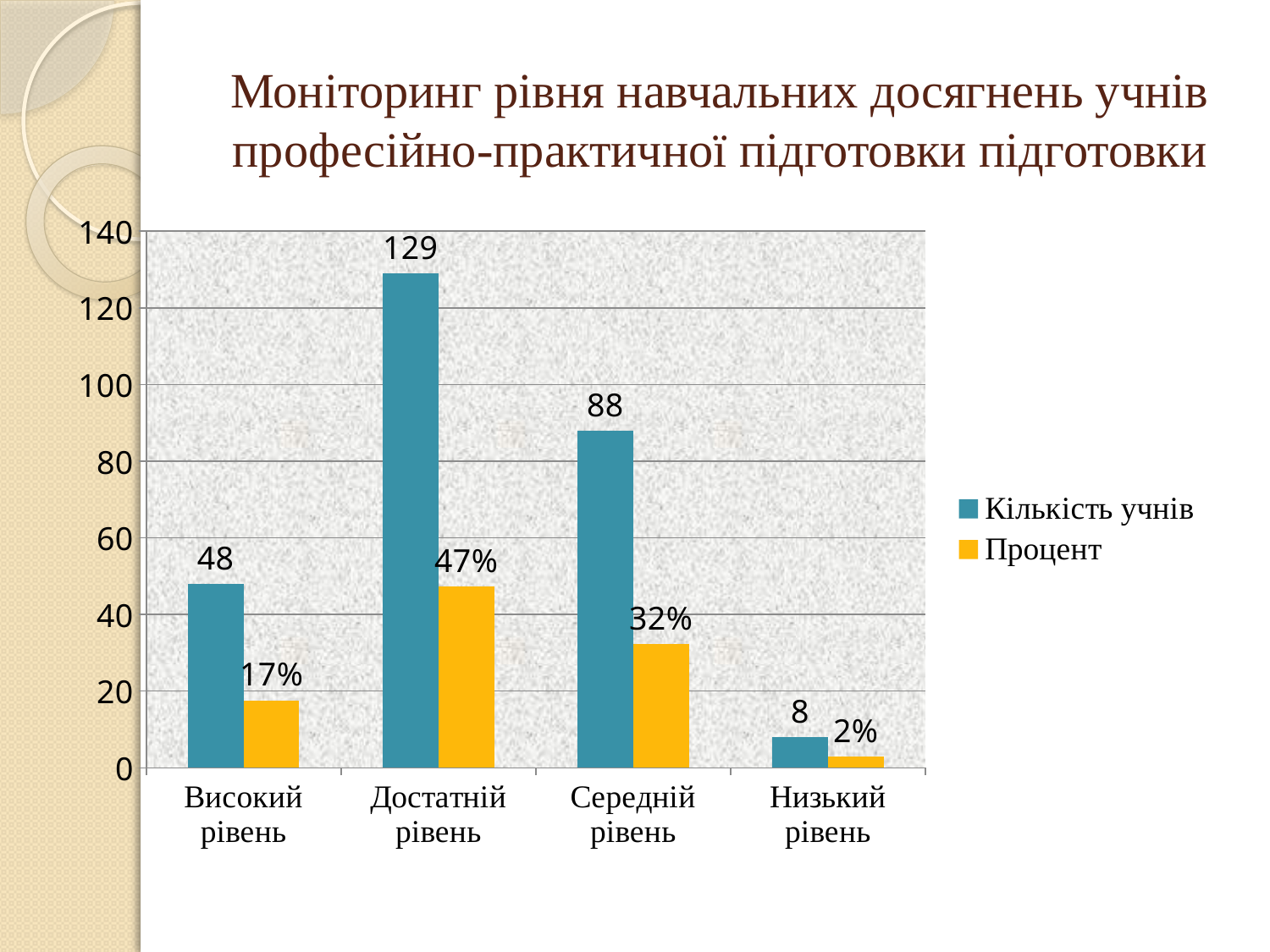
What is the difference in Кількість учнів between Достатній рівень and Середній рівень? 41 What kind of chart is shown on the slide? Bar chart What colour are the bars for the Процент series? Yellow Which is larger: Кількість учнів for Високий рівень or for Середній рівень? Середній рівень What is the value of Кількість учнів for Низький рівень? 8 How many series does the legend list? 2 Which category has the highest value for Кількість учнів? Достатній рівень What is the value of Процент for Середній рівень? 32% What is the value of Процент for Високий рівень? 17% How many categories are shown on the x axis? 4 Which category has the lowest value for Процент? Низький рівень What is the value of Кількість учнів for Достатній рівень? 129